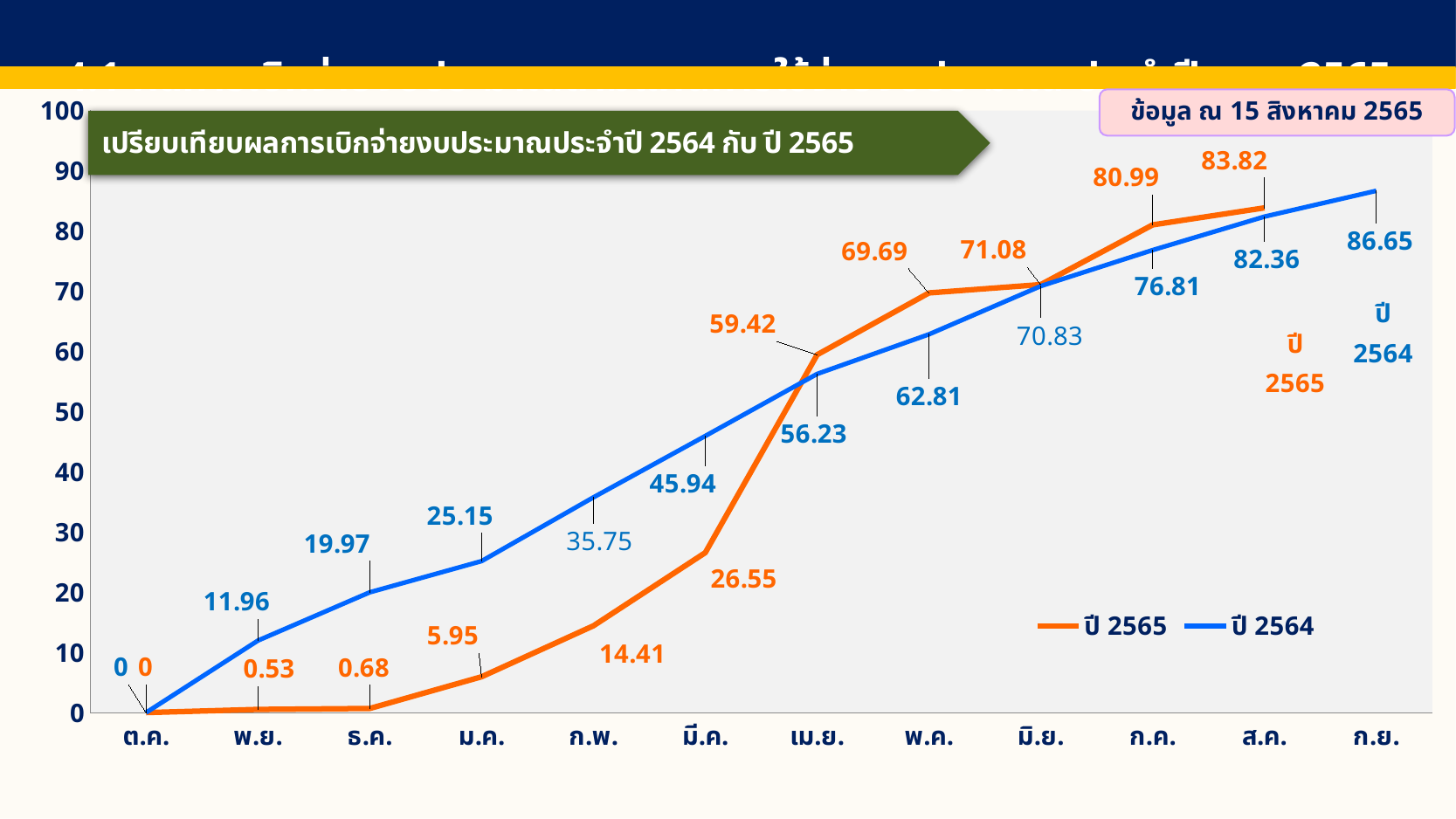
How many months are shown on the x axis? 12 Which series has the higher value in มี.ค., ปี 2565 or ปี 2564? ปี 2564 How many series does the legend list? 2 What is the value for ปี 2565 in เม.ย.? 59.42 What type of chart is shown on the slide? Line chart What is the value for ปี 2565 in ส.ค.? 83.82 What date is the data stated to be as of, according to the note on the slide? 15 สิงหาคม 2565 What is the value for ปี 2564 in ก.พ.? 35.75 What is the value for ปี 2564 in ก.ย.? 86.65 Do the values for ปี 2565 rise or fall from ต.ค. to ส.ค.? Rise What is the difference between ปี 2564 and ปี 2565 in ม.ค.? 19.20 In which month is the value for ปี 2564 the highest? ก.ย.